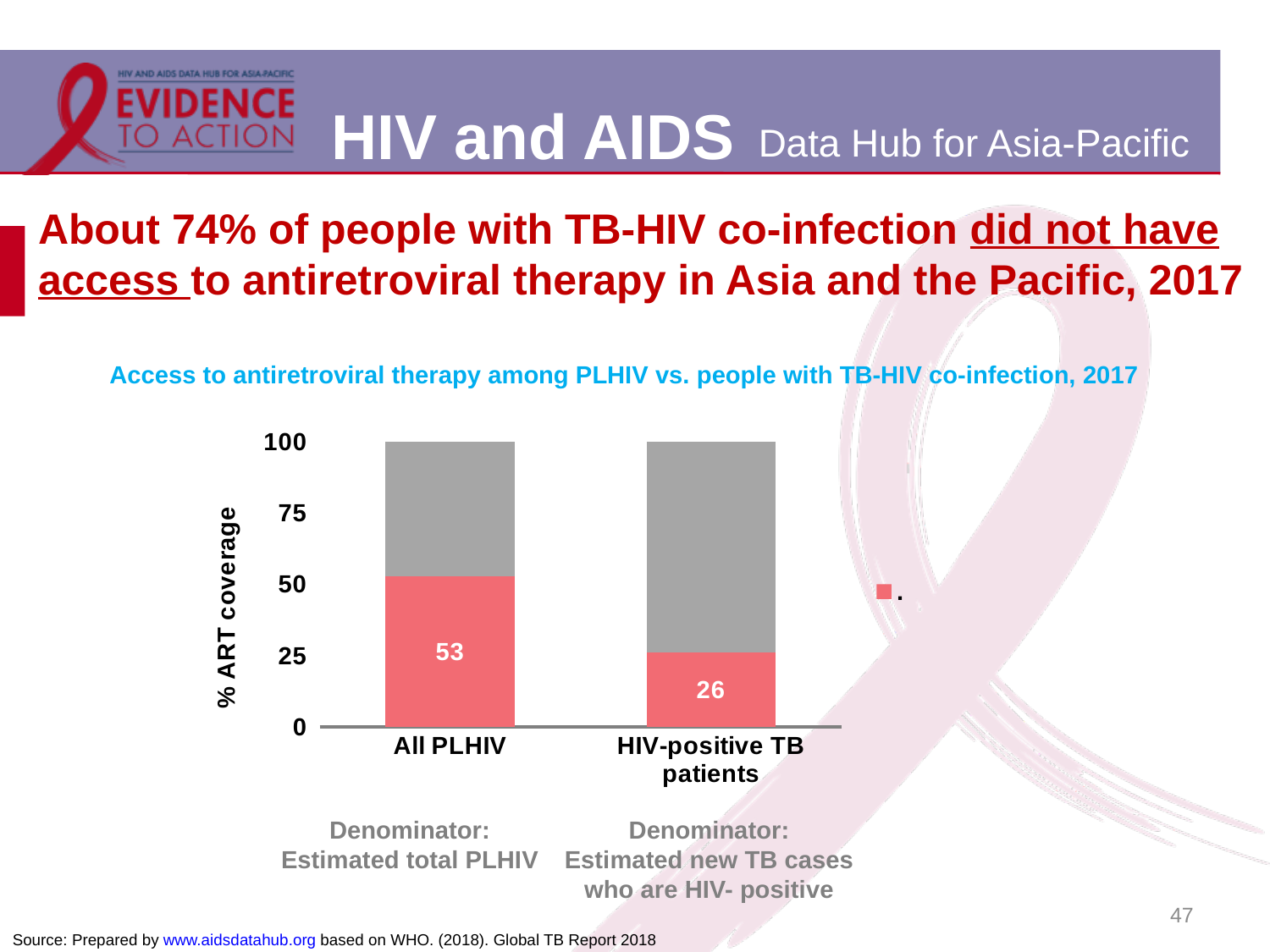
What is the title of the chart? Access to antiretroviral therapy among PLHIV vs. people with TB-HIV co-infection, 2017 What kind of chart is shown on the slide? bar chart What is the label on the y axis of the chart? % ART coverage What is the difference between the ART coverage values for All PLHIV and HIV-positive TB patients? 27 Which category has the lower labelled ART coverage value? HIV-positive TB patients How many categories are shown on the x axis of the chart? 2 Is the ART coverage value for All PLHIV greater or less than 25? greater Is the ART coverage value for All PLHIV larger or smaller than that for HIV-positive TB patients? larger What is the % ART coverage value shown for All PLHIV? 53 Which category has the higher labelled ART coverage value? All PLHIV What is the % ART coverage value shown for HIV-positive TB patients? 26 Is the ART coverage value for HIV-positive TB patients greater or less than 50? less